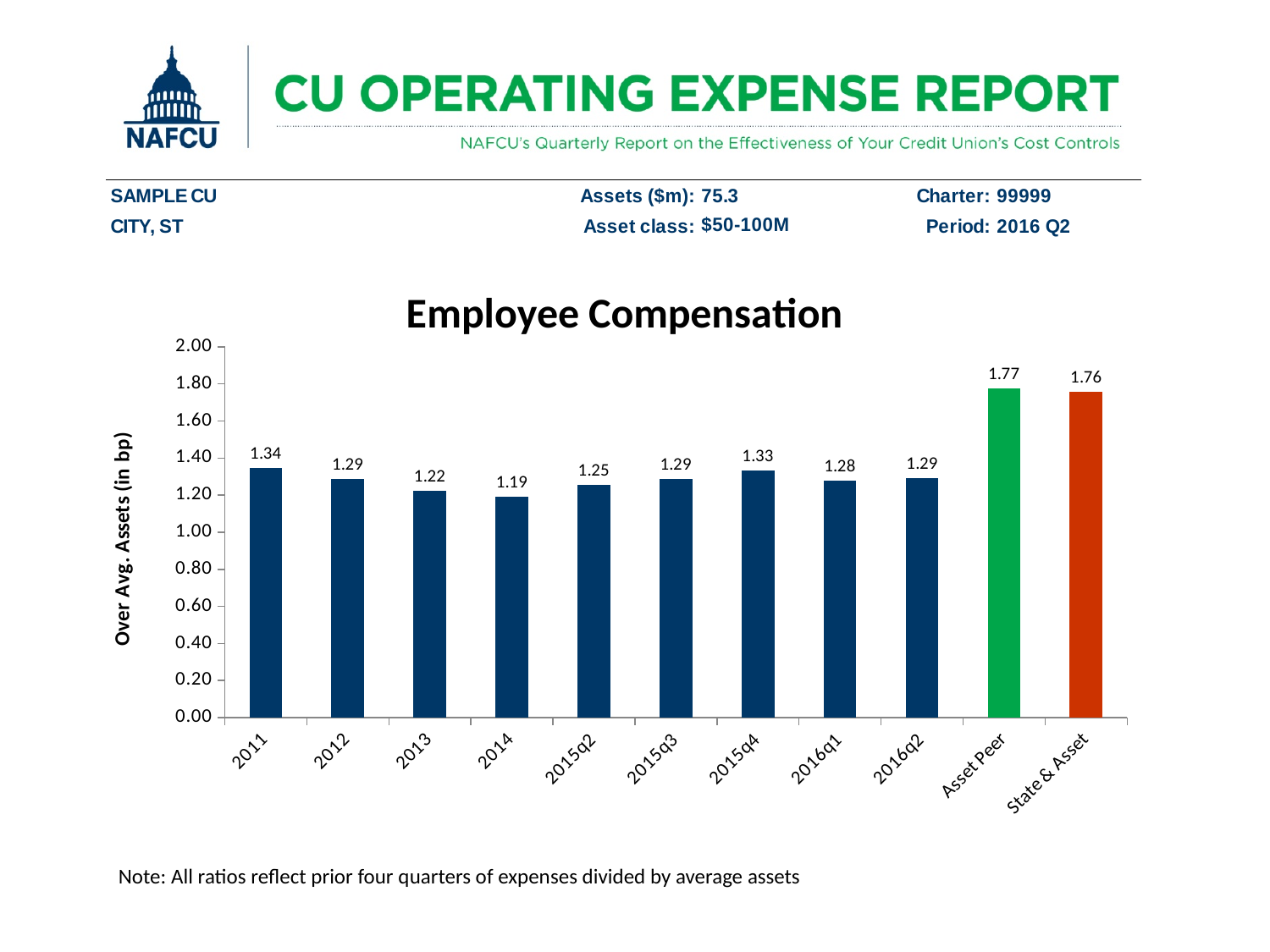
Is the value for 2013 greater or less than 1.40? less What is the value for State & Asset in the Employee Compensation chart? 1.76 What is the value for 2011 in the Employee Compensation chart? 1.34 What is the y-axis label of the Employee Compensation chart? Over Avg. Assets (in bp) Which category has the highest value in the Employee Compensation chart? Asset Peer What is the value for Asset Peer in the Employee Compensation chart? 1.77 Which category has the lowest value in the Employee Compensation chart? 2014 What is the value for 2014 in the Employee Compensation chart? 1.19 What is the difference between the Asset Peer value and the 2016q2 value? 0.48 Which is larger, the value for 2015q4 or the value for 2016q1? 2015q4 What kind of chart is shown on the slide? Bar chart How many bars are shown in the Employee Compensation chart? 11